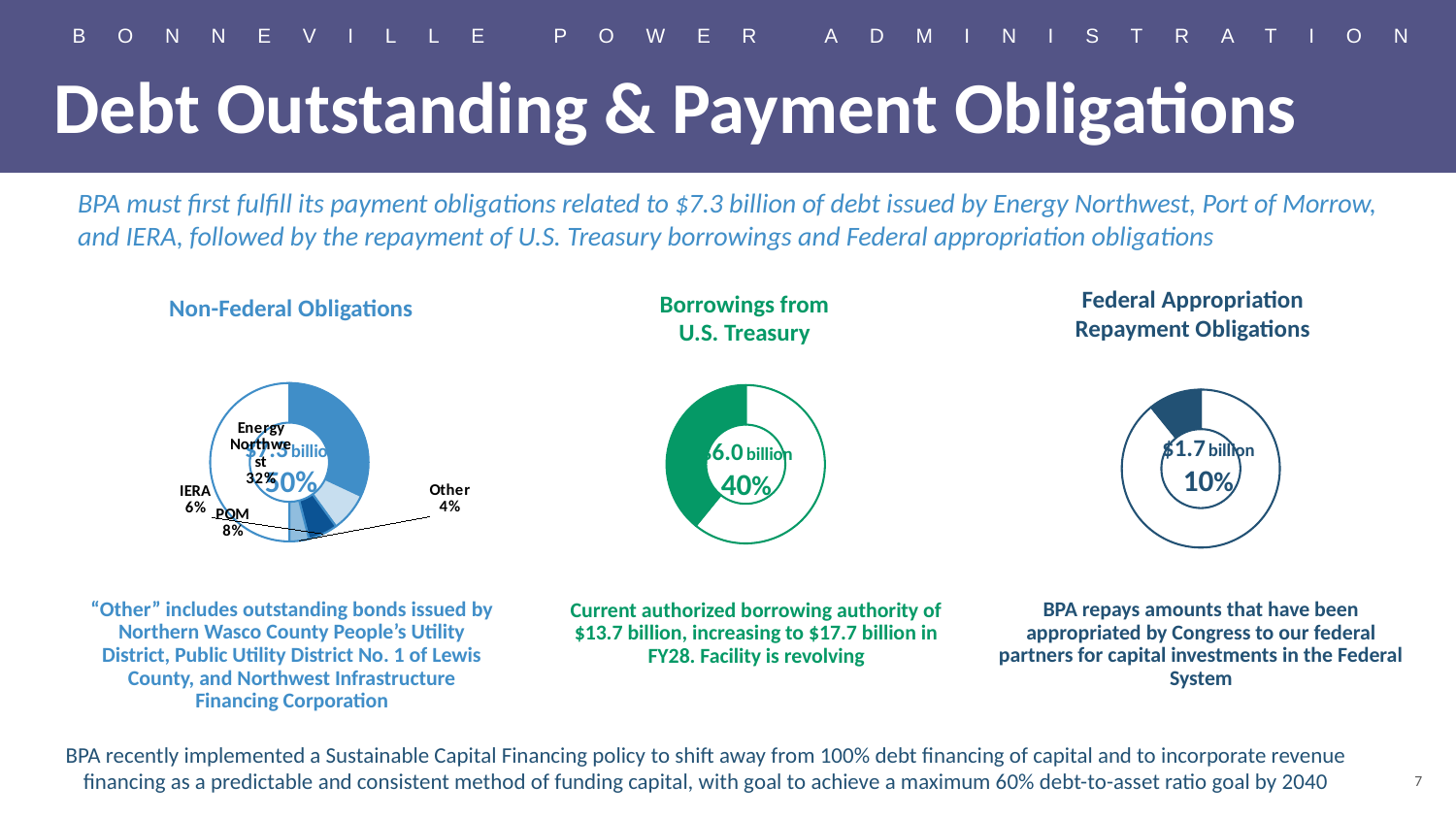
What dollar amount is shown in the center of the Federal Appropriation Repayment Obligations chart? $1.7 billion In the Non-Federal Obligations chart, which labeled category has the largest share? Energy Northwest What percentage is shown in the center of the Borrowings from U.S. Treasury chart? 40% In the Non-Federal Obligations chart, how many percentage points larger is Energy Northwest's share than POM's share? 24 percentage points In the Non-Federal Obligations chart, what percentage is labeled for IERA? 6% In the Non-Federal Obligations chart, what percentage is labeled for Energy Northwest? 32% In the Non-Federal Obligations chart, what percentage is labeled for POM? 8% In the Non-Federal Obligations chart, which labeled category has the smallest share? Other In the Non-Federal Obligations chart, which has the larger share, IERA or POM? POM How many donut charts are shown on the slide? 3 What kind of chart is used for Non-Federal Obligations? pie (donut) chart In the Non-Federal Obligations chart, what percentage is labeled for Other? 4%